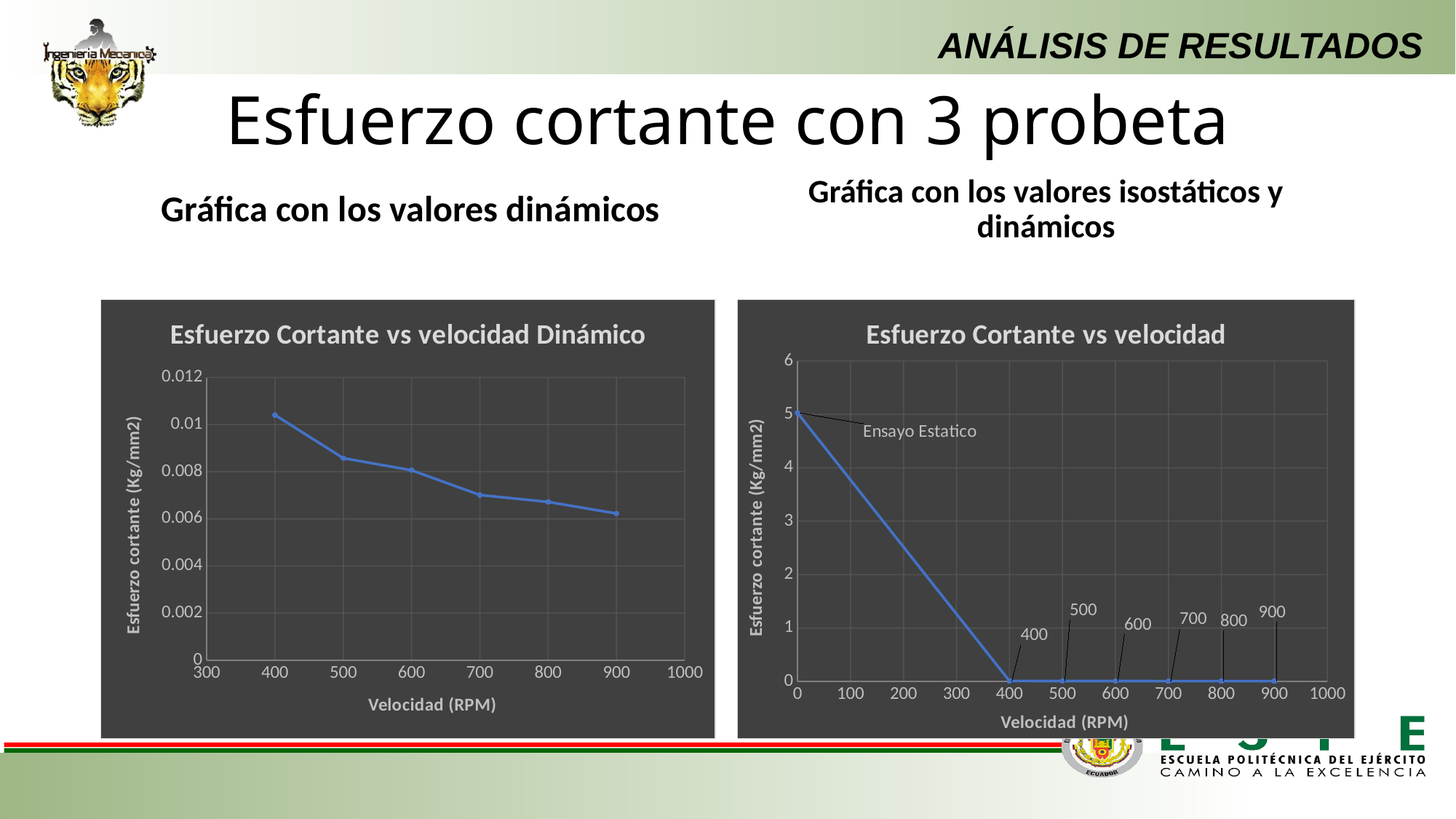
What is the x-axis title of the right chart 'Esfuerzo Cortante vs velocidad'? Velocidad (RPM) What kind of chart is the left chart titled 'Esfuerzo Cortante vs velocidad Dinámico'? line chart What kind of chart is the right chart titled 'Esfuerzo Cortante vs velocidad'? line chart In the left chart 'Esfuerzo Cortante vs velocidad Dinámico', at which velocity is the shear stress highest? 400 RPM In the left chart 'Esfuerzo Cortante vs velocidad Dinámico', is the value at 700 RPM greater or less than 0.008? less In the left chart 'Esfuerzo Cortante vs velocidad Dinámico', is the value at 500 RPM greater or less than 0.008? greater In the left chart 'Esfuerzo Cortante vs velocidad Dinámico', does the shear stress rise or fall as velocity increases? fall In the left chart 'Esfuerzo Cortante vs velocidad Dinámico', at which velocity is the shear stress lowest? 900 RPM In the left chart 'Esfuerzo Cortante vs velocidad Dinámico', which has the larger shear stress, 400 RPM or 900 RPM? 400 RPM In the left chart 'Esfuerzo Cortante vs velocidad Dinámico', how many data points are plotted? 6 In the right chart 'Esfuerzo Cortante vs velocidad', which point has the highest shear stress? Ensayo Estatico (0 RPM)